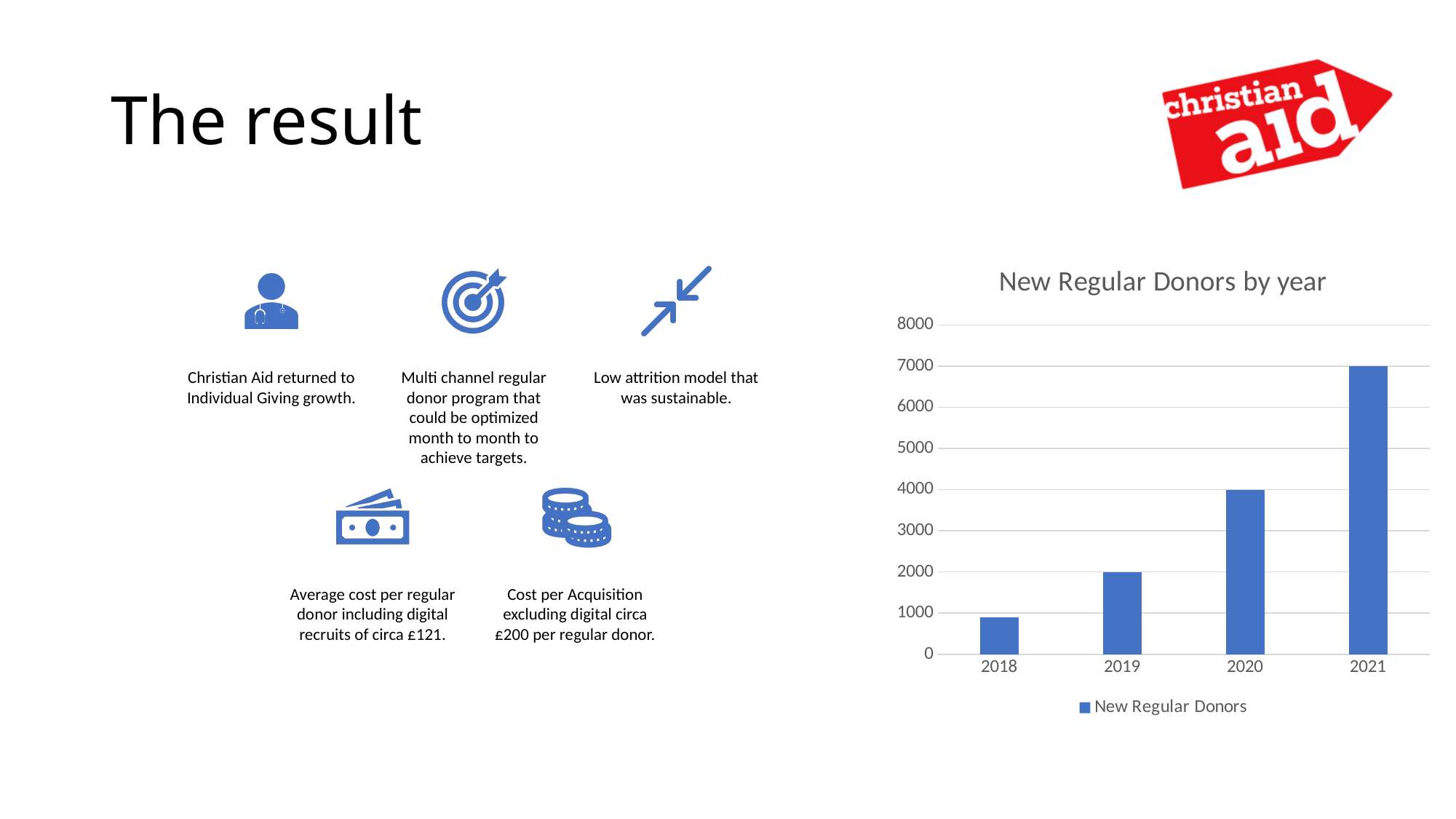
Do the values rise or fall from 2018 to 2021? rise Which year has the lowest number of new regular donors? 2018 What type of chart is shown on the slide? bar chart How many series does the chart legend list? 1 Which year has more new regular donors, 2019 or 2020? 2020 What is the title of the chart on the slide? New Regular Donors by year How many years are shown on the x axis of the chart? 4 What is the value for 2020 in the chart? 4000 Which year has the highest number of new regular donors? 2021 Is the value for 2021 greater or less than 6000? greater What is the name of the series in the chart legend? New Regular Donors